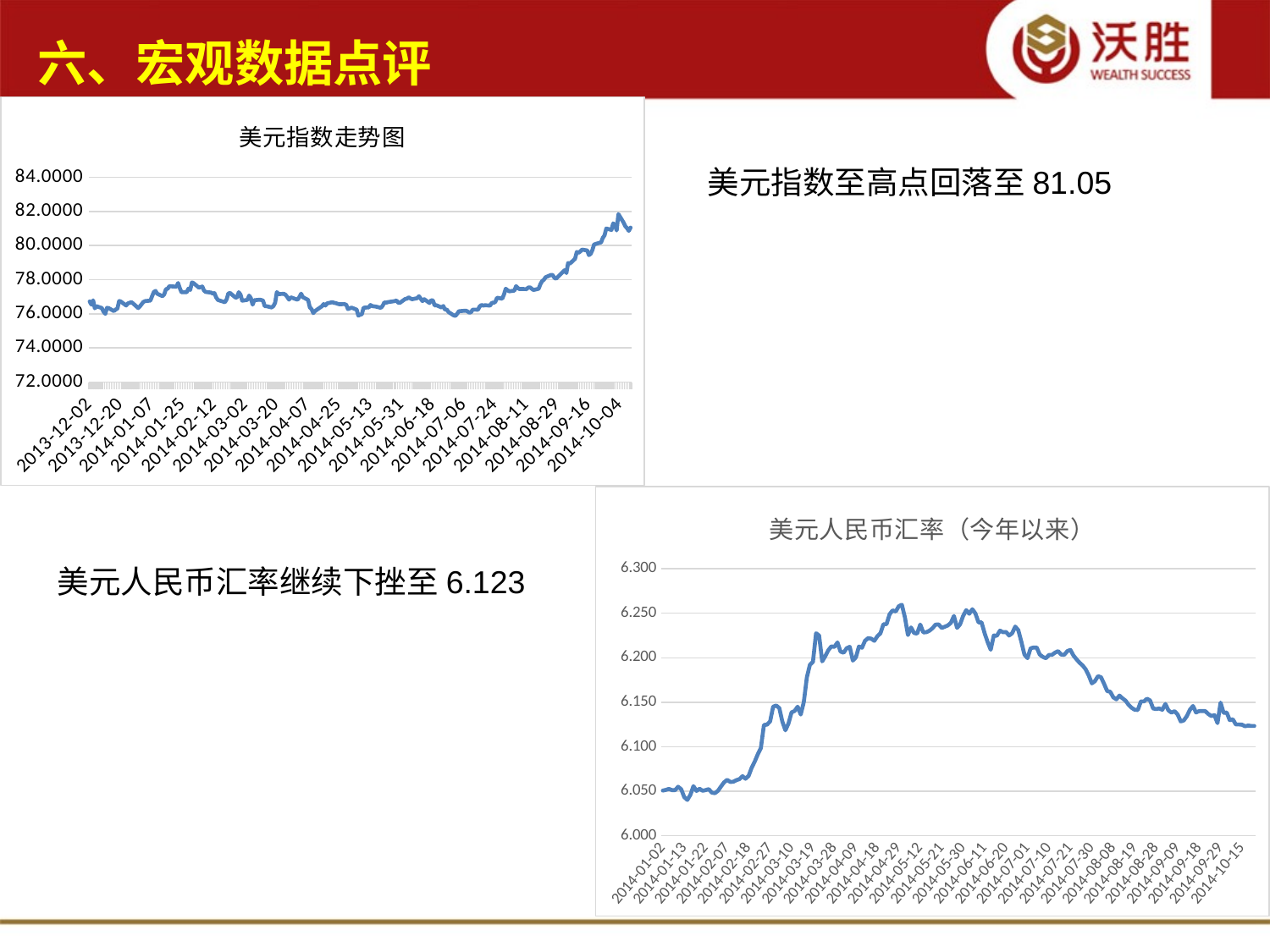
In the chart titled 美元人民币汇率（今年以来）, does the line rise or fall from 2014-07-21 to 2014-10-15? fall In the chart titled 美元人民币汇率（今年以来）, is the value at 2014-10-15 greater or less than 6.150? less In the chart titled 美元人民币汇率（今年以来）, is the value at 2014-01-02 greater or less than 6.100? less What type of chart is the chart titled 美元指数走势图? line chart In the chart titled 美元指数走势图, does the line overall rise or fall from 2014-07-06 to 2014-10-04? rise What is the title of the chart in the upper left of the slide? 美元指数走势图 In the chart titled 美元指数走势图, is the value at 2014-07-06 greater or less than 78.0000? less What is the title of the chart in the lower right of the slide? 美元人民币汇率（今年以来） What type of chart is the chart titled 美元人民币汇率（今年以来）? line chart